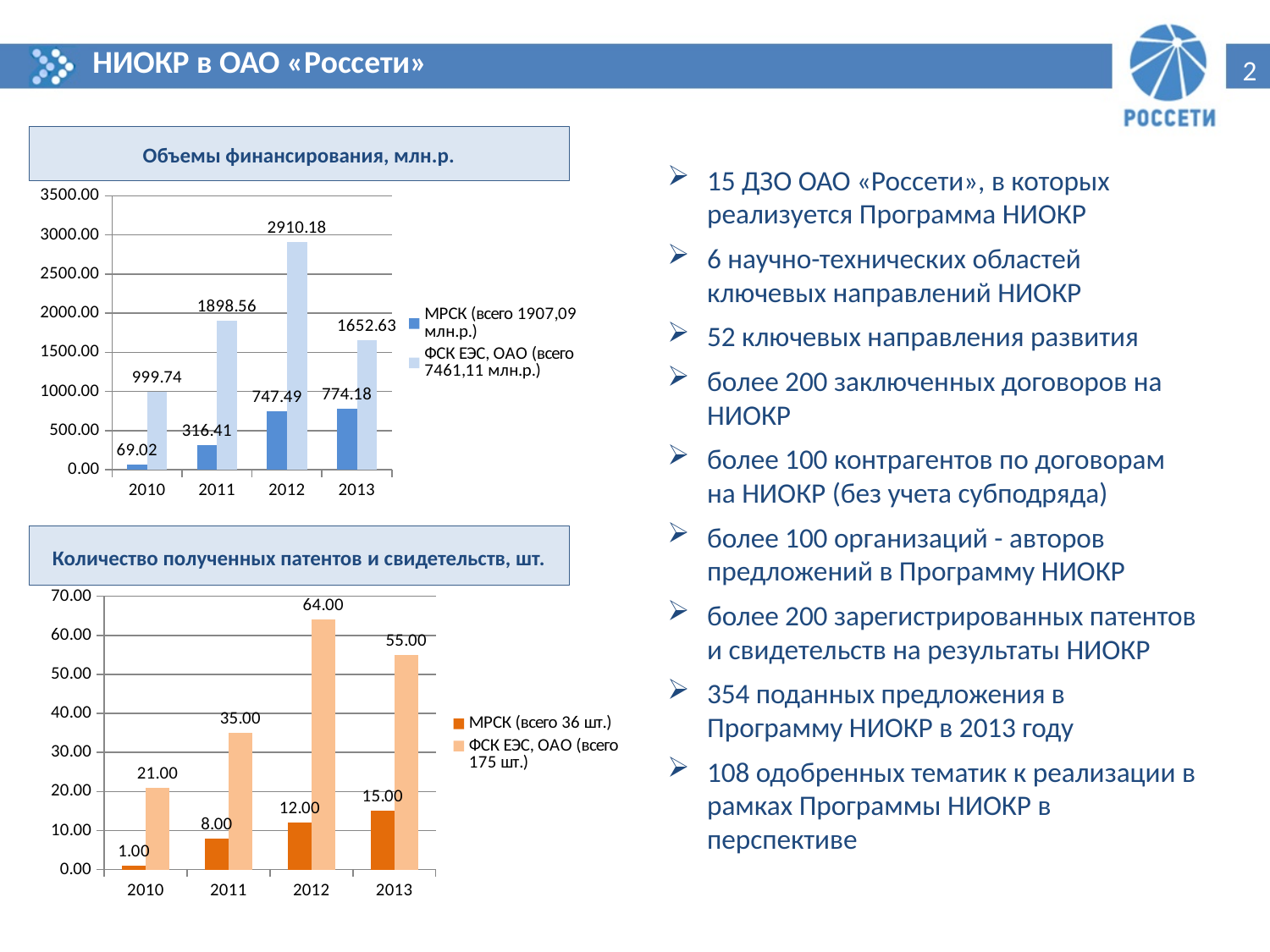
In the chart titled «Объемы финансирования, млн.р.», what is the value for ФСК ЕЭС, ОАО in 2012? 2910.18 In the chart titled «Количество полученных патентов и свидетельств, шт.», what is the value for ФСК ЕЭС, ОАО in 2012? 64.00 In the chart titled «Количество полученных патентов и свидетельств, шт.», does the МРСК value rise or fall from 2010 to 2013? rise In the chart titled «Количество полученных патентов и свидетельств, шт.», which is larger: the ФСК ЕЭС, ОАО value in 2012 or in 2013? 2012 In the chart titled «Количество полученных патентов и свидетельств, шт.», how many years are shown on the x axis? 4 In the chart titled «Объемы финансирования, млн.р.», in which year is the МРСК value lowest? 2010 In the chart titled «Объемы финансирования, млн.р.», what is the value for МРСК in 2011? 316.41 What kind of chart is the chart titled «Количество полученных патентов и свидетельств, шт.»? bar chart In the chart titled «Объемы финансирования, млн.р.», in which year is the ФСК ЕЭС, ОАО value highest? 2012 In the chart titled «Количество полученных патентов и свидетельств, шт.», what is the value for МРСК in 2013? 15.00 In the chart titled «Объемы финансирования, млн.р.», how many series does the legend list? 2 In the chart titled «Объемы финансирования, млн.р.», what is the difference between the ФСК ЕЭС, ОАО value and the МРСК value in 2013? 878.45